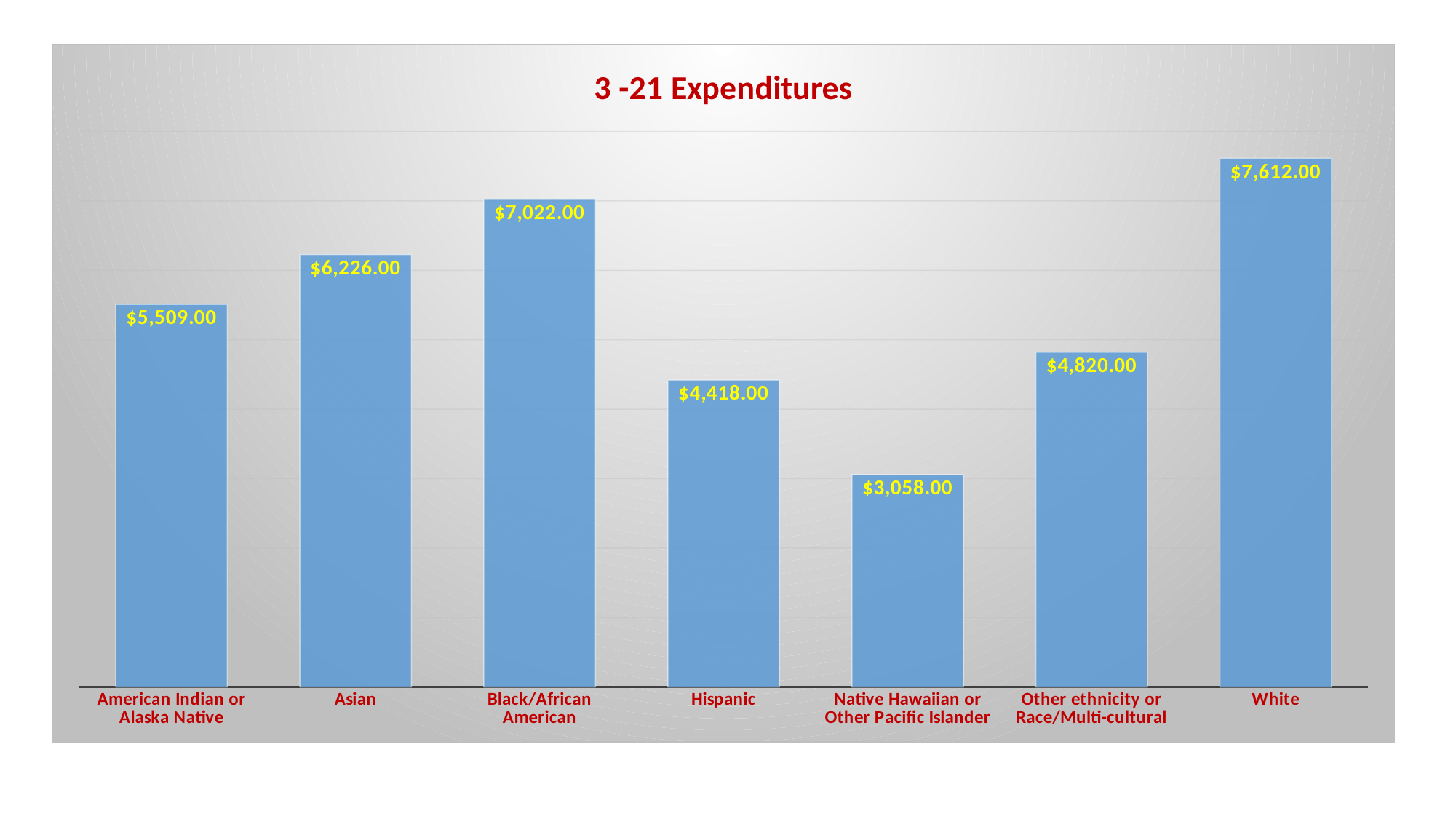
What is the value for Hispanic? $4,418.00 What is the value for White? $7,612.00 What is the value for Native Hawaiian or Other Pacific Islander? $3,058.00 How many categories are shown on the x axis? 7 What is the title of the chart? 3 -21 Expenditures Which is larger, the value for Asian or the value for Hispanic? Asian What is the difference between the values for White and Black/African American? $590.00 What kind of chart is this? Bar chart What is the difference between the values for Asian and American Indian or Alaska Native? $717.00 Which category has the highest value? White What is the value for Other ethnicity or Race/Multi-cultural? $4,820.00 Which category has the lowest value? Native Hawaiian or Other Pacific Islander